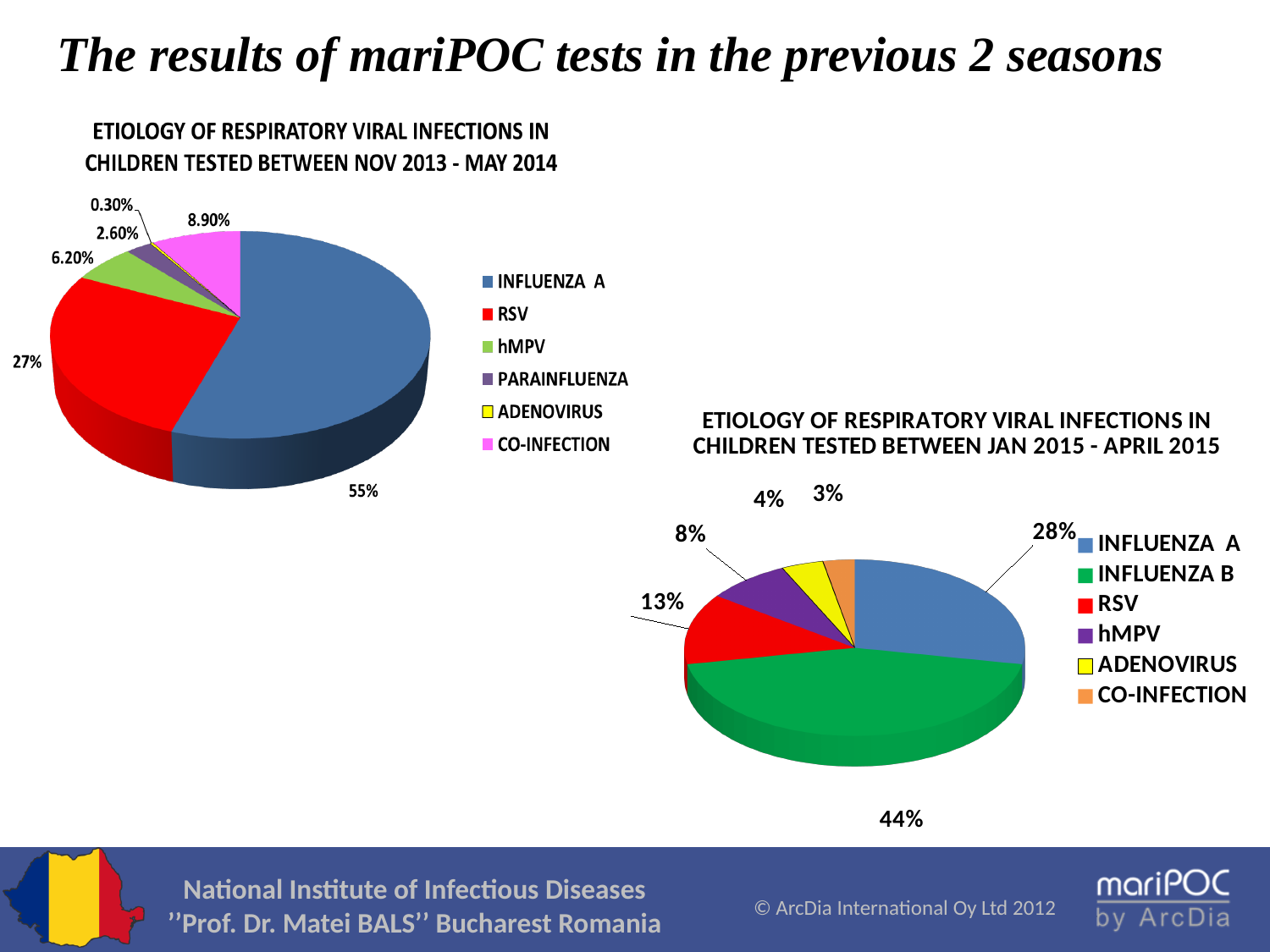
What type of chart is the Nov 2013 - May 2014 chart (left)? Pie chart In the Nov 2013 - May 2014 chart (left), what is the difference between the INFLUENZA A and RSV shares? 28% How many categories does the legend of the Jan 2015 - April 2015 chart (right) list? 6 In the Jan 2015 - April 2015 chart (right), what share of infections is INFLUENZA B? 44% In the Nov 2013 - May 2014 chart (left), what share of infections is RSV? 27% In the Nov 2013 - May 2014 chart (left), which category has the smallest share? ADENOVIRUS In the Jan 2015 - April 2015 chart (right), which is larger, hMPV or ADENOVIRUS? hMPV In the Jan 2015 - April 2015 chart (right), which category has the largest share? INFLUENZA B In the Nov 2013 - May 2014 chart (left), what share of infections is INFLUENZA A? 55% In the Jan 2015 - April 2015 chart (right), what share of infections is RSV? 13% In the Jan 2015 - April 2015 chart (right), what colour represents INFLUENZA B? Green In the Nov 2013 - May 2014 chart (left), what share is CO-INFECTION? 8.90%